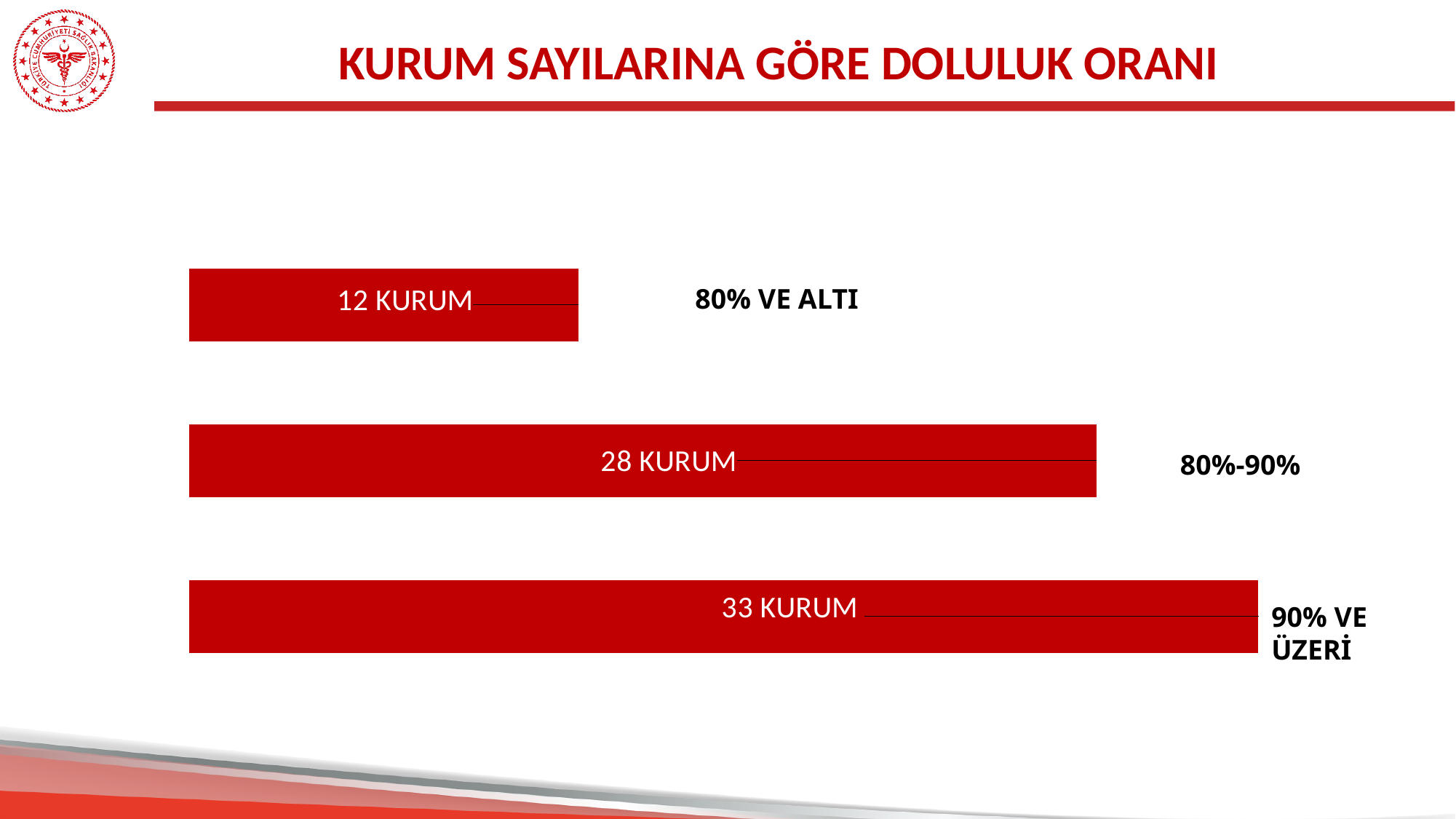
How many institutions (kurum) are in the '80% VE ALTI' occupancy category? 12 KURUM What is the difference in the number of institutions between the '80%-90%' and '80% VE ALTI' categories? 16 How many institutions are in the '80%-90%' occupancy category? 28 KURUM What is the title of the chart on the slide? KURUM SAYILARINA GÖRE DOLULUK ORANI Which occupancy category has the highest number of institutions? 90% VE ÜZERİ Which occupancy category has the lowest number of institutions? 80% VE ALTI How many institutions are in the '90% VE ÜZERİ' occupancy category? 33 KURUM How many occupancy categories are shown in the chart? 3 What is the difference in the number of institutions between the '90% VE ÜZERİ' and '80% VE ALTI' categories? 21 Which category has more institutions: '80%-90%' or '90% VE ÜZERİ'? 90% VE ÜZERİ What kind of chart is shown on the slide? Bar chart What is the total number of institutions across all three categories? 73